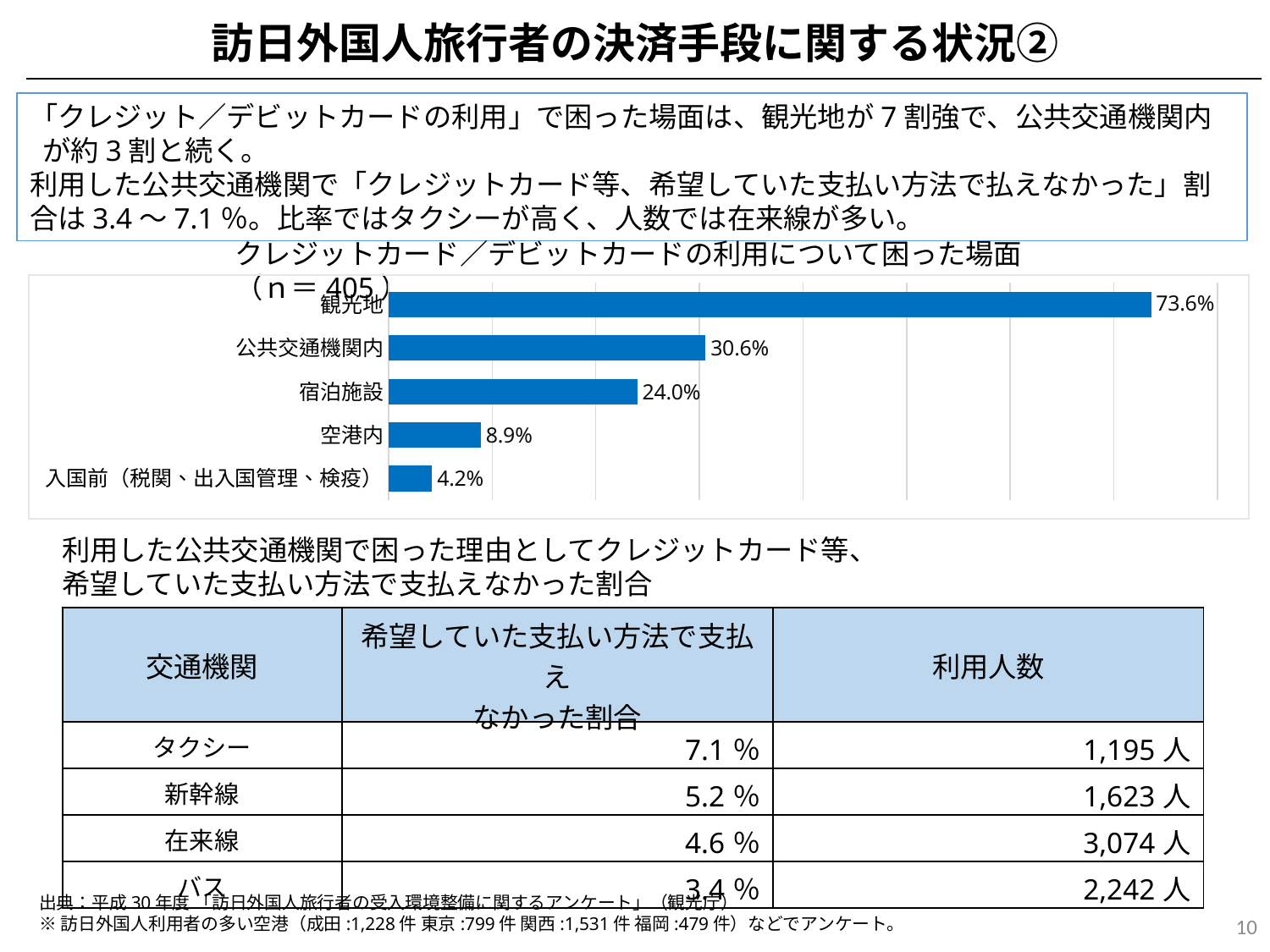
What is the value for 入国前（税関、出入国管理、検疫） in the bar chart? 4.2% What is the value for 観光地 in the bar chart? 73.6% What is the value for 空港内 in the bar chart? 8.9% How many categories are shown in the bar chart? 5 Which category has the highest value in the bar chart? 観光地 What is the value for 公共交通機関内 in the bar chart? 30.6% What is the difference between the values for 観光地 and 公共交通機関内 in the bar chart? 43.0% Which is larger in the bar chart, the value for 宿泊施設 or the value for 空港内? 宿泊施設 What kind of chart is shown on the slide? Bar chart Which category has the lowest value in the bar chart? 入国前（税関、出入国管理、検疫） What is the value for 宿泊施設 in the bar chart? 24.0% What is the sample size (n) stated in the bar chart's title? 405